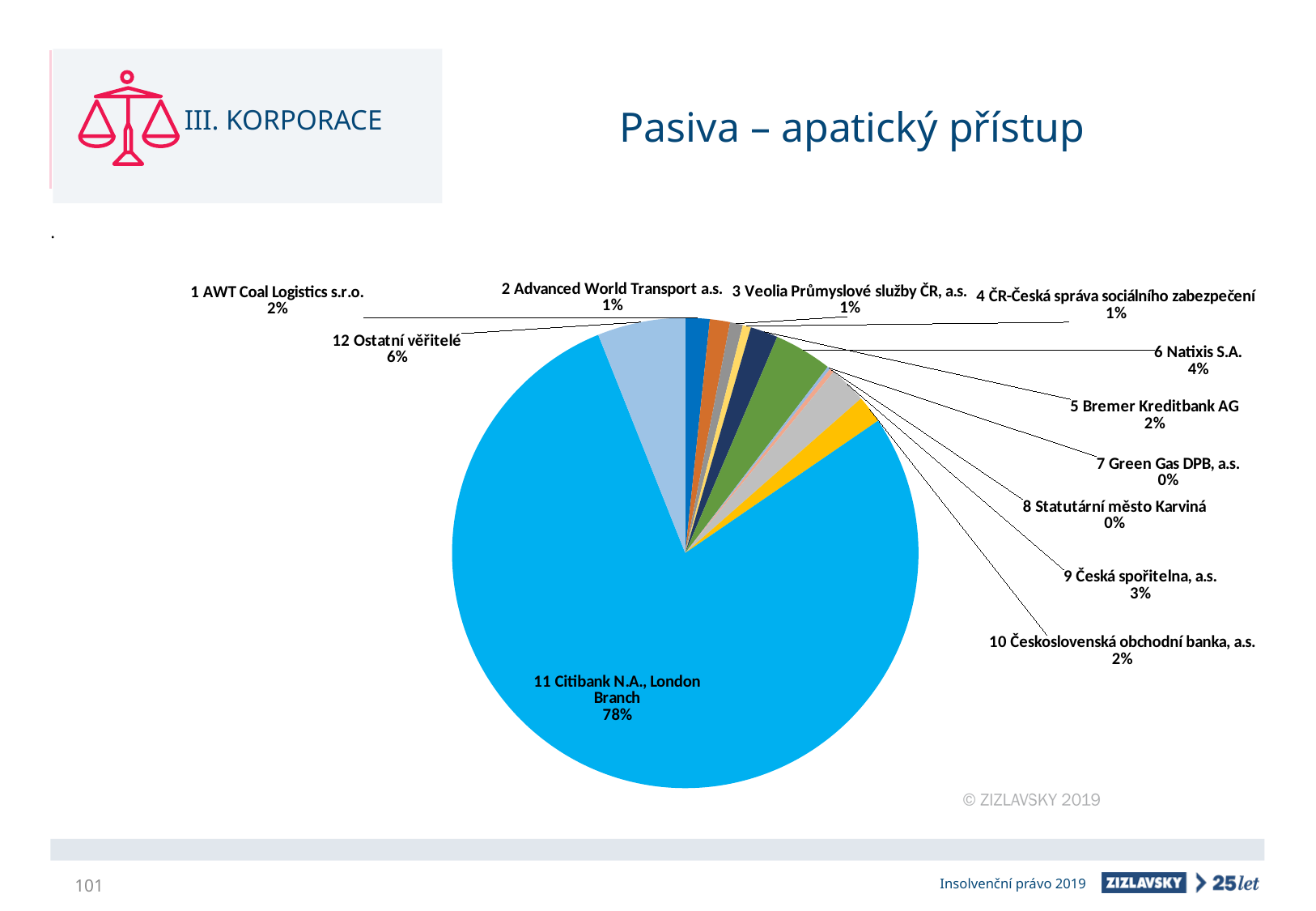
What is the difference in percentage points between 11 Citibank N.A., London Branch and 12 Ostatní věřitelé? 72 What percentage is shown for 6 Natixis S.A.? 4% What share of the pie does 11 Citibank N.A., London Branch hold? 78% What is the title of the slide containing the pie chart? Pasiva – apatický přístup What is the difference in percentage points between 6 Natixis S.A. and 1 AWT Coal Logistics s.r.o.? 2 Which has the larger share: 6 Natixis S.A. or 9 Česká spořitelna, a.s.? 6 Natixis S.A. Which creditor has the largest share of the pie? 11 Citibank N.A., London Branch What percentage is shown for 7 Green Gas DPB, a.s.? 0% What percentage is shown for 12 Ostatní věřitelé? 6% What percentage is shown for 9 Česká spořitelna, a.s.? 3% How many slices does the pie chart have? 12 What kind of chart is shown on the slide? pie chart